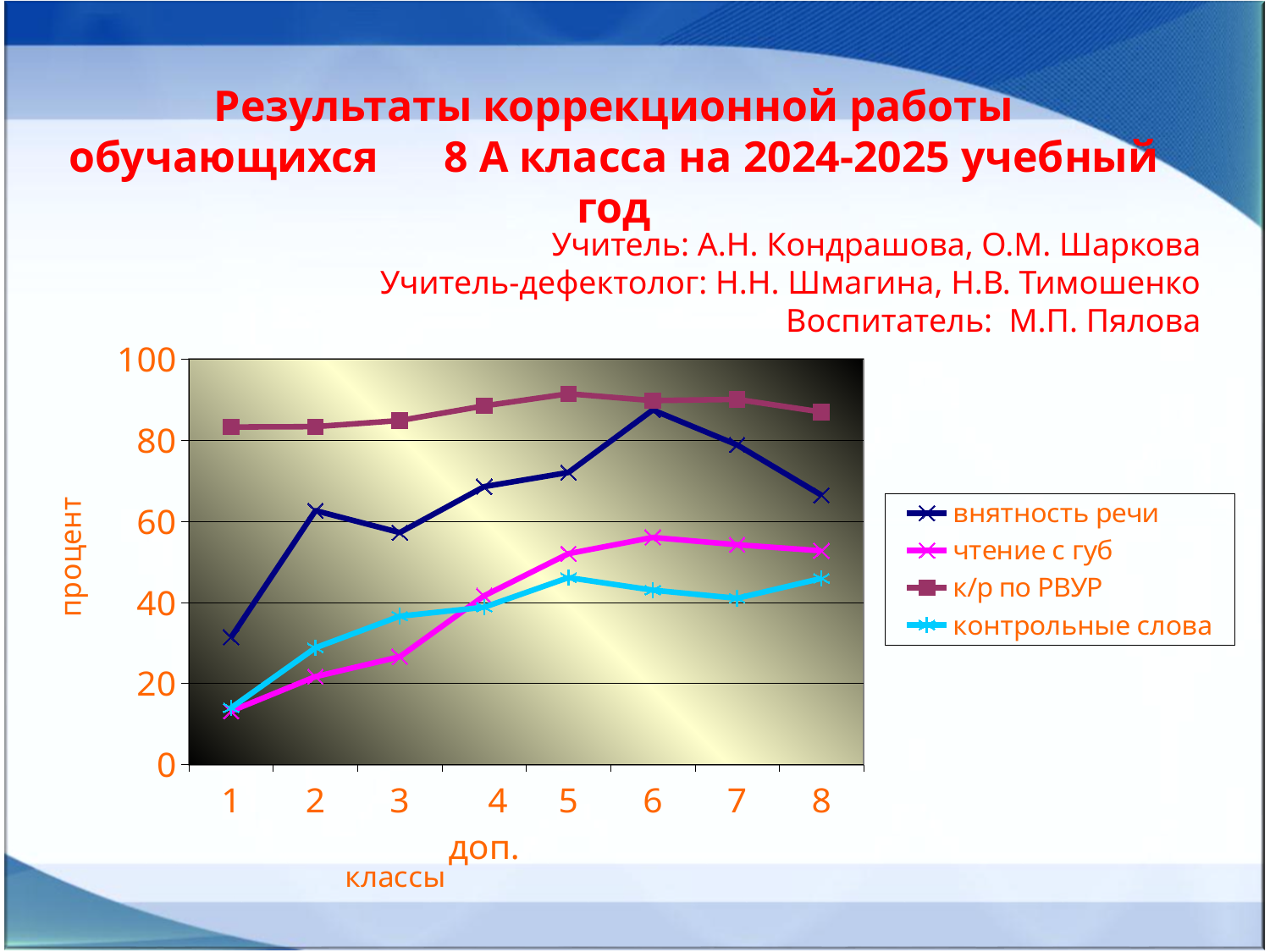
Which series has the lowest value at category 2? чтение с губ How many series does the legend list? 4 Is the value for к/р по РВУР at category 5 greater or less than 80? greater What kind of chart is shown on the slide? line chart How many categories are shown along the x axis? 8 Is the value for внятность речи at category 1 greater or less than 40? less Which series has the highest value at category 8? к/р по РВУР What is the title of the y axis? процент At category 4, which is larger: внятность речи or чтение с губ? внятность речи At which category does внятность речи reach its highest value? 6 Is the value for внятность речи at category 6 greater or less than 80? greater